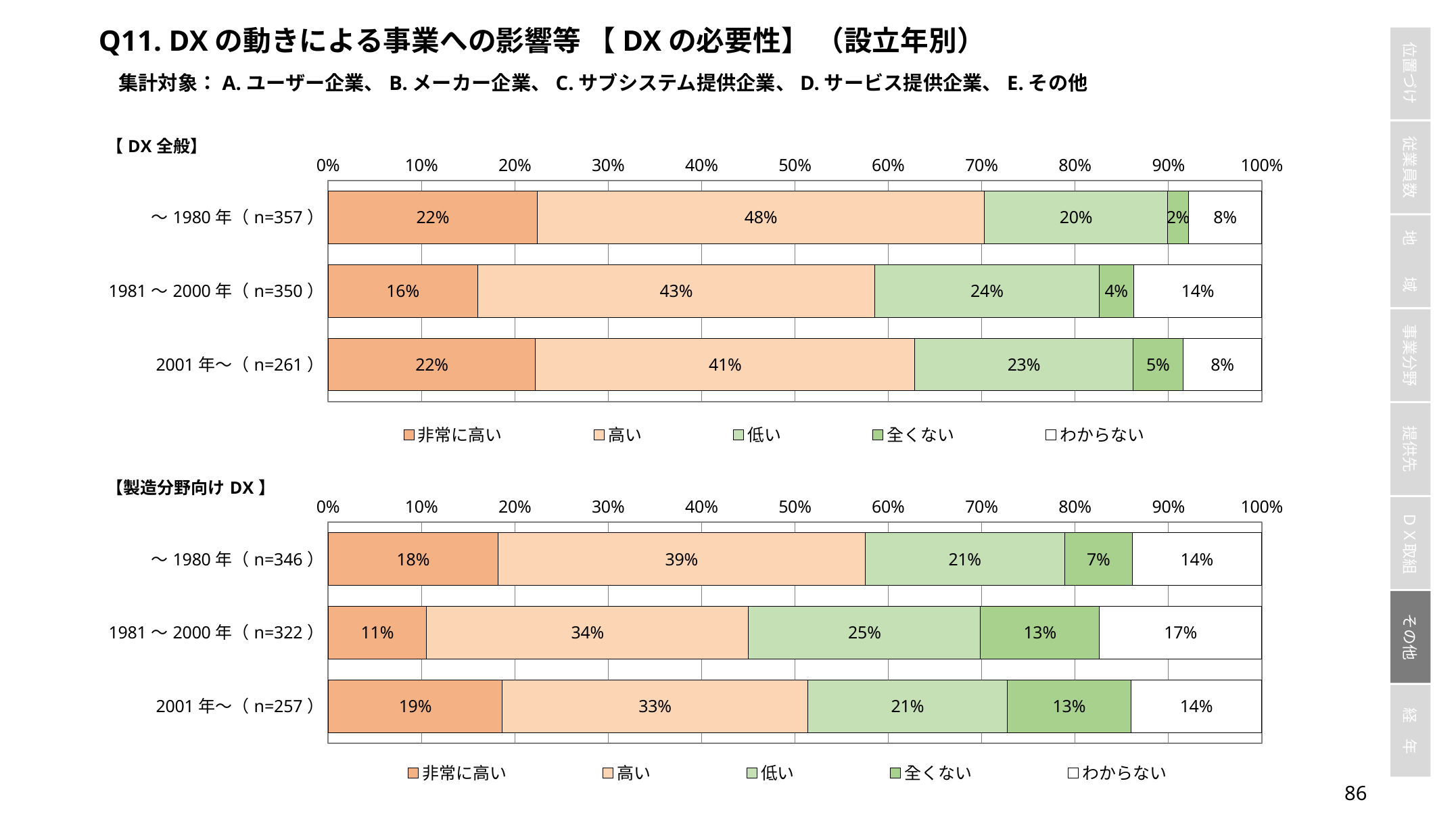
In the 【DX全般】 chart, what is the difference between the 高い values for ～1980年（n=357） and 2001年～（n=261）? 7% In the 【製造分野向けDX】 chart, what is the value of わからない for 2001年～（n=257）? 14% How many series does the legend of the 【DX全般】 chart list? 5 How many categories are shown in the 【製造分野向けDX】 chart? 3 In the 【製造分野向けDX】 chart, which is larger: 低い for 1981～2000年（n=322） or 低い for 2001年～（n=257）? 1981～2000年（n=322） In the 【DX全般】 chart, which category has the lowest value for 非常に高い? 1981～2000年（n=350） In the 【DX全般】 chart, what is the value of 高い for ～1980年（n=357）? 48% In the 【製造分野向けDX】 chart, which category has the highest value for 高い? ～1980年（n=346） What kind of chart is the 【製造分野向けDX】 chart? Stacked bar chart In the 【製造分野向けDX】 chart, what is the value of 非常に高い for 1981～2000年（n=322）? 11% In the 【製造分野向けDX】 chart, what is the combined total of 非常に高い and 高い for 2001年～（n=257）? 52% In the 【DX全般】 chart, what is the value of 全くない for 1981～2000年（n=350）? 4%